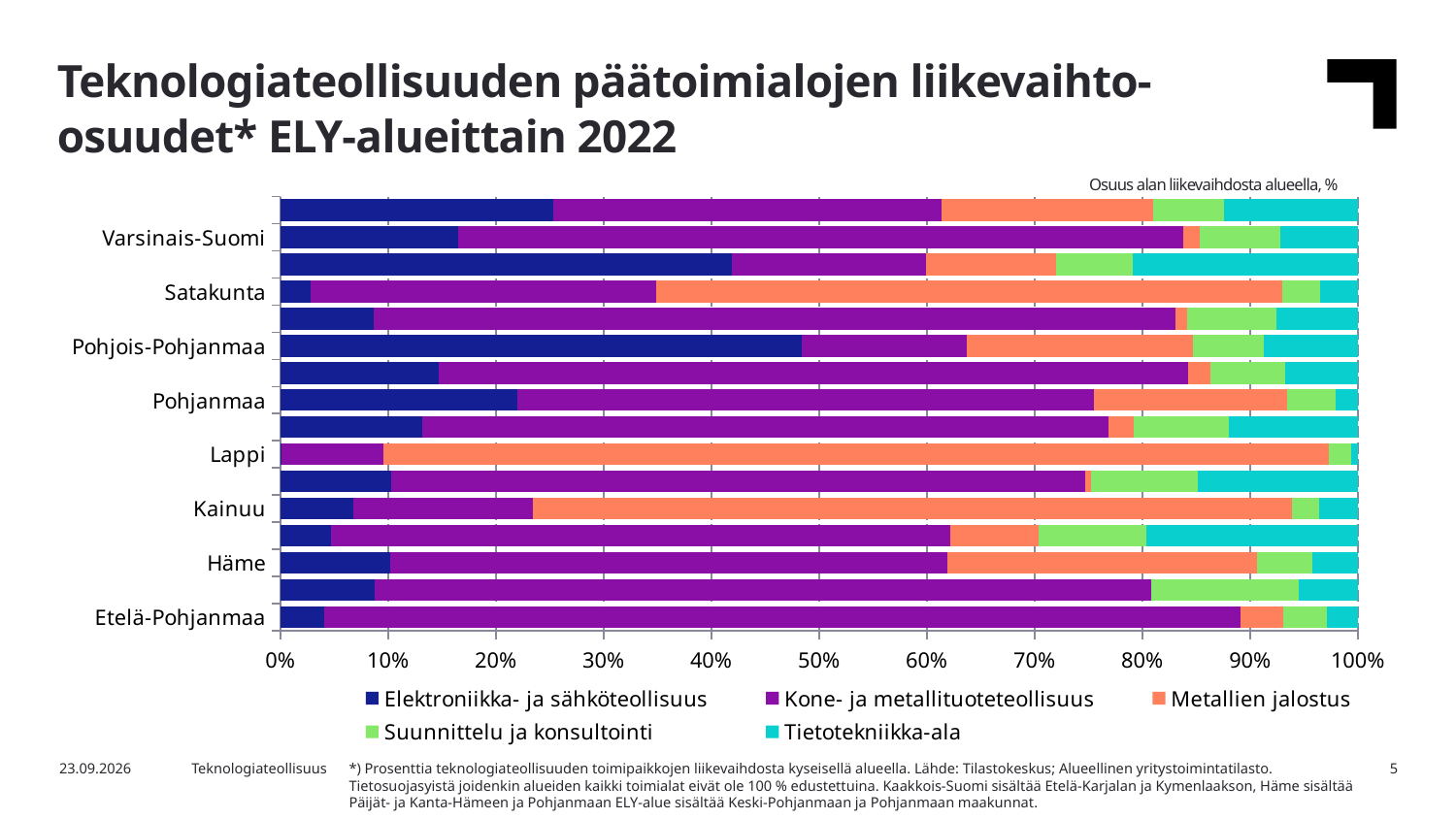
Is the share of Metallien jalostus for Lappi greater or less than 80%? greater Which series is shown in orange in the legend? Metallien jalostus How many region labels are shown on the vertical axis of the chart? 8 What is the highest value shown on the horizontal axis? 100% Which has the larger share of Elektroniikka- ja sähköteollisuus, Pohjois-Pohjanmaa or Satakunta? Pohjois-Pohjanmaa Is the share of Metallien jalostus for Kainuu greater or less than 60%? greater Is the share of Metallien jalostus for Satakunta greater or less than 50%? greater What kind of chart is shown on the slide? Stacked bar chart How many series does the legend list? 5 Which series has the largest share in the Lappi bar? Metallien jalostus